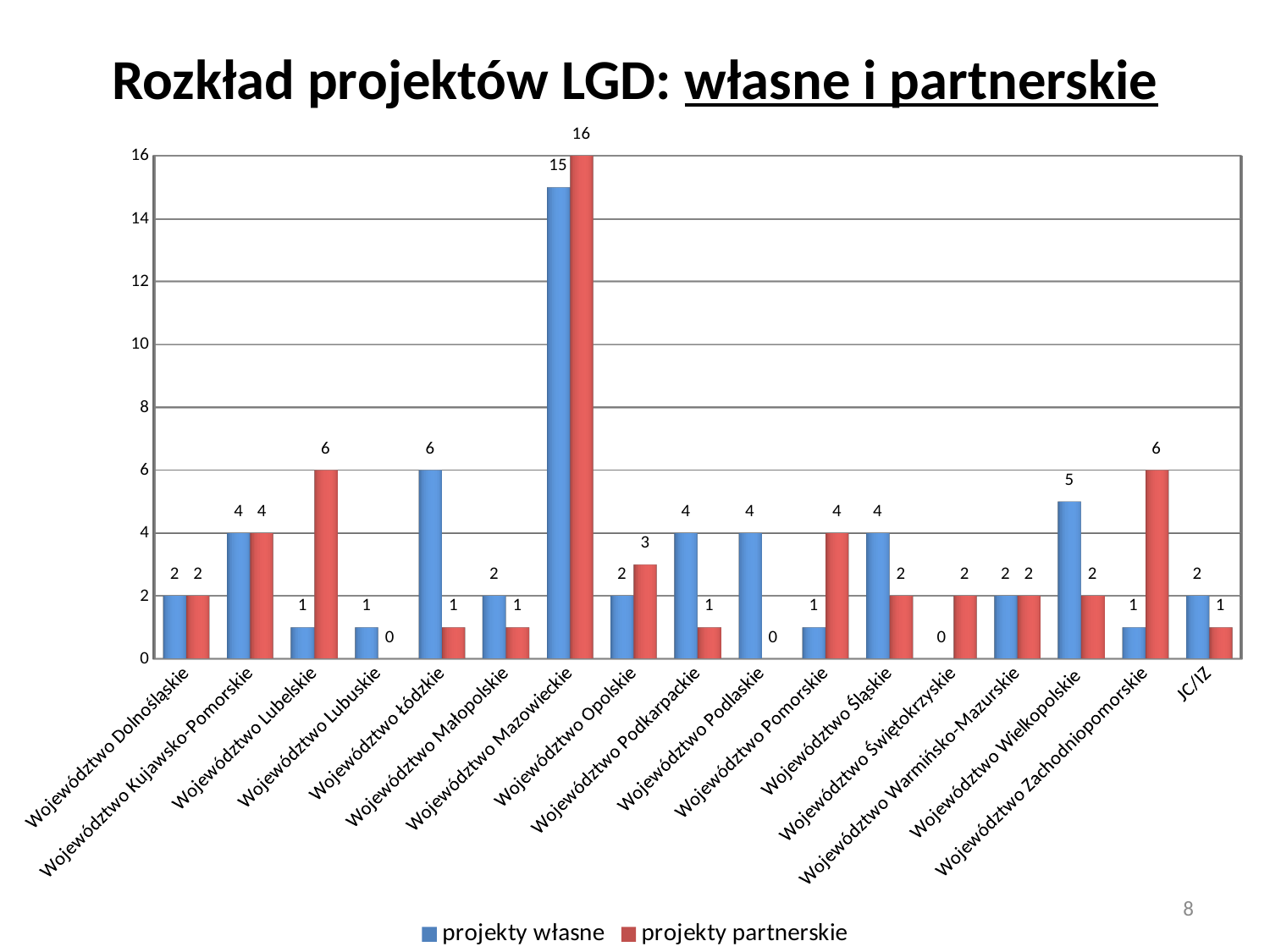
What is the value of projekty własne for Województwo Wielkopolskie? 5 How many series does the legend list? 2 Which is larger for Województwo Łódzkie: projekty własne or projekty partnerskie? projekty własne How many categories are shown on the x axis? 17 What kind of chart is shown on the slide? bar chart What is the value of projekty partnerskie for Województwo Podlaskie? 0 Is the value of projekty własne for Województwo Mazowieckie greater or less than 10? greater What is the value of projekty własne for Województwo Mazowieckie? 15 Which colour represents projekty partnerskie in the legend? red Which category has the highest value for projekty partnerskie? Województwo Mazowieckie What is the difference between projekty partnerskie and projekty własne for Województwo Lubelskie? 5 What is the value of projekty partnerskie for Województwo Zachodniopomorskie? 6